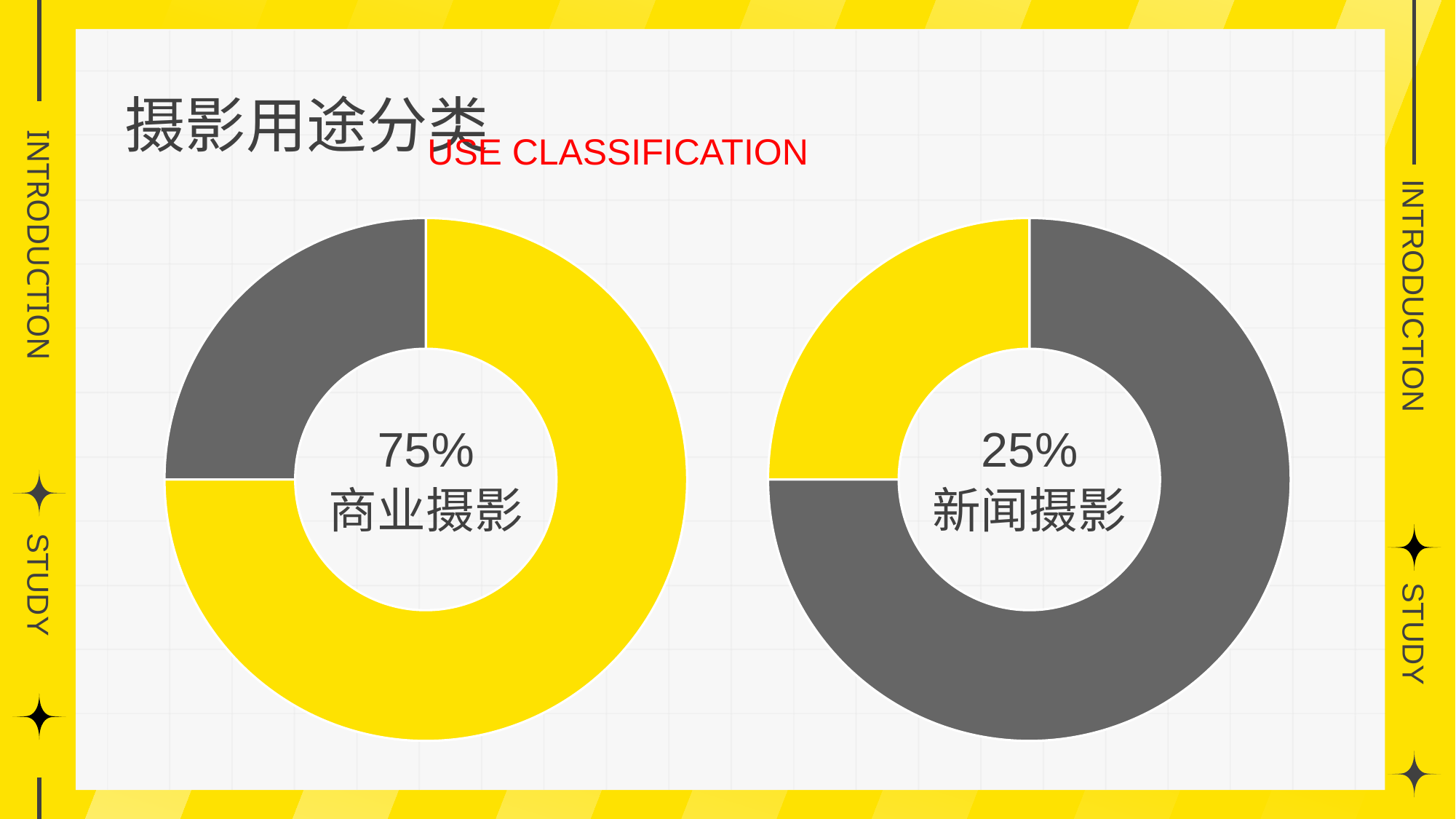
In the left chart, what percentage is shown for 商业摄影? 75% In the left chart, is the yellow segment larger or smaller than the grey segment? Larger In the left chart, what share of the ring does the yellow segment (商业摄影) take up? 75% In the right chart, is the yellow segment larger or smaller than the grey segment? Smaller How many donut charts are shown on the slide? 2 Which is larger, the percentage for 商业摄影 in the left chart or the percentage for 新闻摄影 in the right chart? 商业摄影 In the right chart, what percentage is shown for 新闻摄影? 25% In the right chart, what share of the ring does the yellow segment (新闻摄影) take up? 25% What is the Chinese title of the slide? 摄影用途分类 What is the difference between the 商业摄影 percentage (left chart) and the 新闻摄影 percentage (right chart)? 50% What colour is the segment representing 新闻摄影 in the right chart? Yellow What kind of chart is used on the left of the slide? Donut (pie) chart